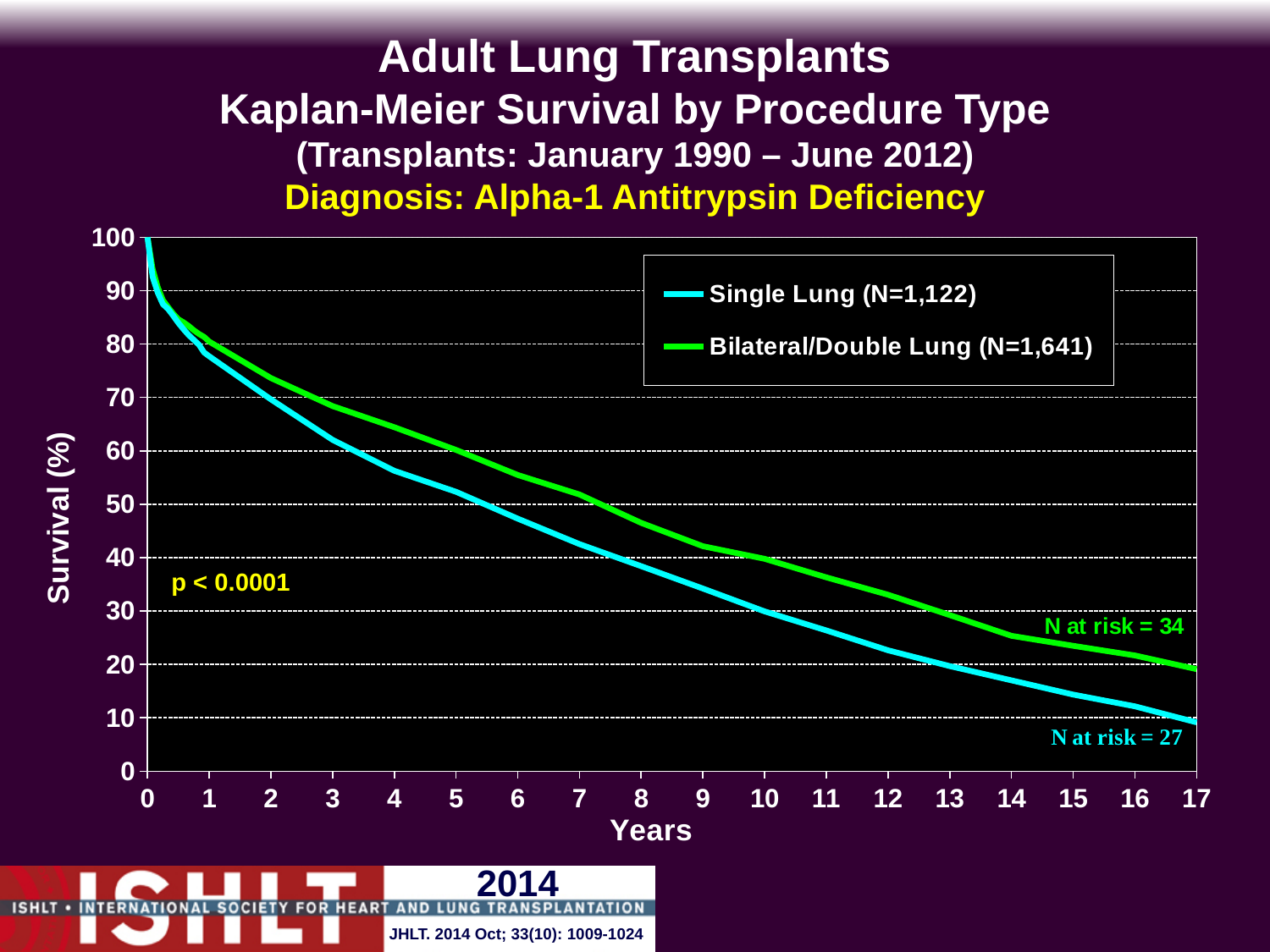
What is the N at risk shown for the Bilateral/Double Lung curve at the right end of the chart? 34 What kind of chart is shown on the slide? Line chart Is the survival for Bilateral/Double Lung at 3 years greater or less than 60%? greater What diagnosis is named in the chart title? Alpha-1 Antitrypsin Deficiency How many series does the legend list? 2 What p-value is printed on the chart? p < 0.0001 Which procedure type has the higher survival at 10 years, Single Lung or Bilateral/Double Lung? Bilateral/Double Lung Is the survival for Single Lung at 15 years greater or less than 20%? less Do the survival curves rise or fall as years increase? Fall How many Single Lung transplants (N) are given in the legend? 1,122 How many Bilateral/Double Lung transplants (N) are given in the legend? 1,641 What is the N at risk shown for the Single Lung curve at the right end of the chart? 27